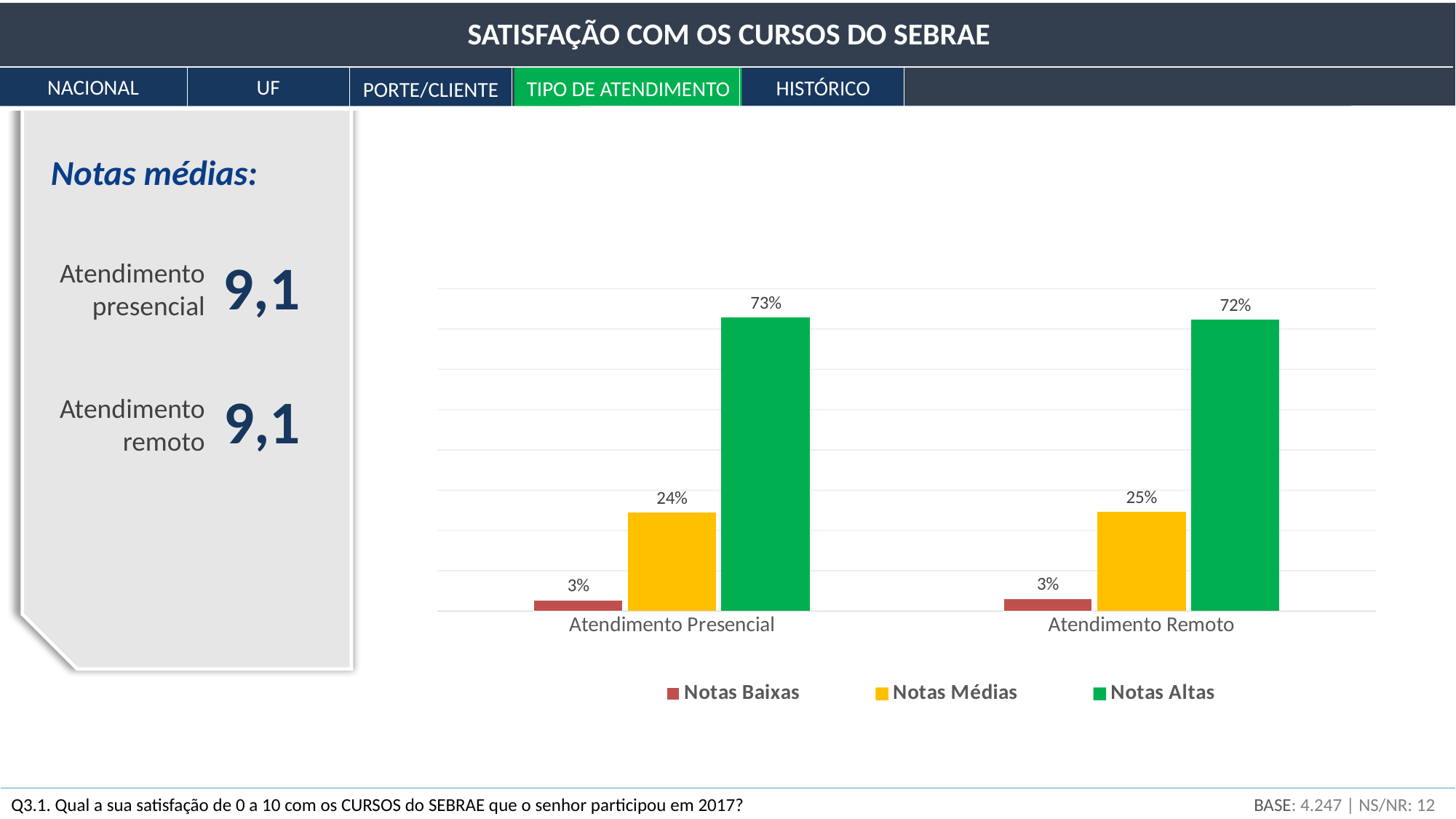
Which series has the lowest value for Atendimento Presencial? Notas Baixas How many categories are shown on the x axis of the chart? 2 Which is larger: Notas Médias for Atendimento Presencial or Notas Médias for Atendimento Remoto? Atendimento Remoto What kind of chart is shown on the slide? Bar chart Which series has the highest value for Atendimento Remoto? Notas Altas What is the difference between Notas Altas and Notas Médias for Atendimento Presencial? 49% What colour represents the Notas Altas series in the chart? Green How many series does the chart legend list? 3 What is the value of Notas Altas for Atendimento Remoto? 72% What is the value of Notas Baixas for Atendimento Presencial? 3% What is the value of Notas Altas for Atendimento Presencial? 73% What is the value of Notas Médias for Atendimento Remoto? 25%